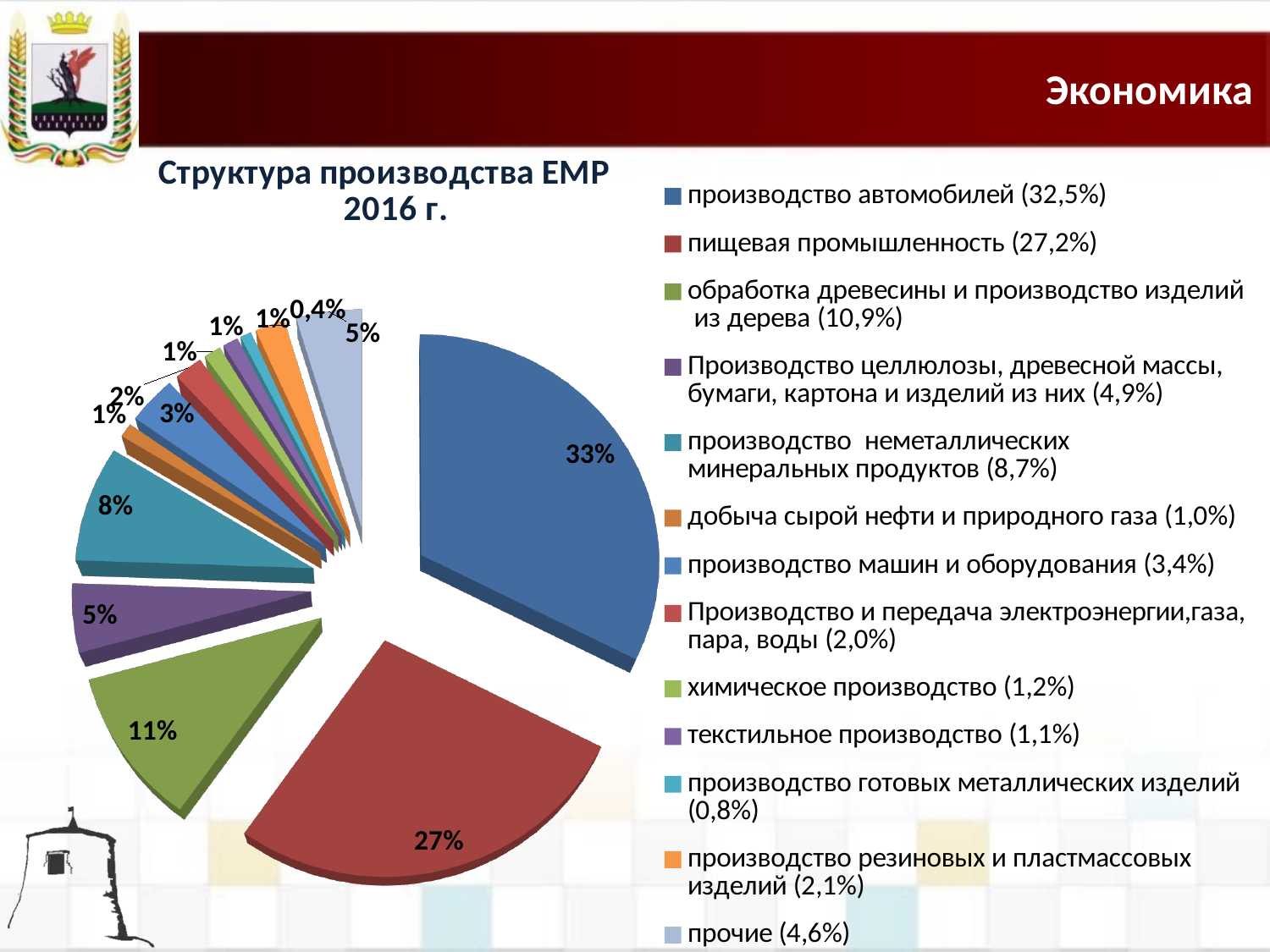
Which slice is larger: пищевая промышленность or обработка древесины и производство изделий из дерева? пищевая промышленность What kind of chart is shown on the slide? pie chart According to the legend, what share does прочие have? 4,6% By how many percentage points does the labelled share of производство автомобилей exceed that of пищевая промышленность? 6 What percentage is labelled on the slice for обработка древесины и производство изделий из дерева? 11% According to the legend, what share does производство машин и оборудования have? 3,4% What percentage is labelled on the slice for пищевая промышленность? 27% What percentage is labelled on the slice for производство неметаллических минеральных продуктов? 8% What percentage is labelled on the slice for производство автомобилей? 33% Which category has the largest slice of the pie? производство автомобилей What is the title of the chart? Структура производства ЕМР 2016 г. How many categories does the legend of the pie chart list? 13